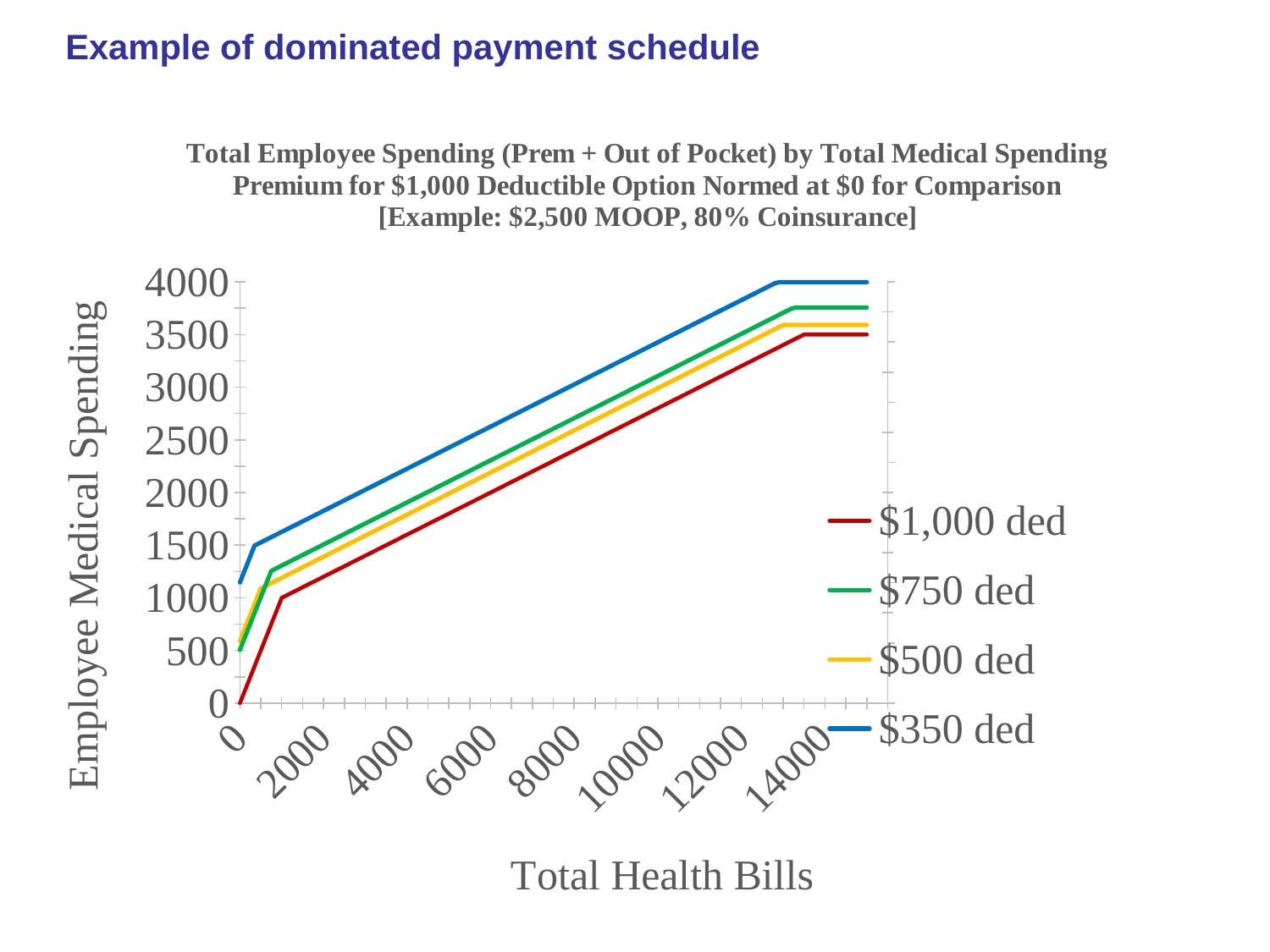
What is the title of the x axis? Total Health Bills What kind of chart is shown on the slide? line chart What is the value of the $1,000 ded series at total health bills of 0? 0 Is the value for the $1,000 ded series at total health bills of 4000 greater or less than 2000? less Which series has the highest employee medical spending across the range of total health bills? $350 ded Do the lines rise or fall as total health bills increase from 0 to 12000? rise What are the four series listed in the legend? $1,000 ded, $750 ded, $500 ded, $350 ded Is the value for the $350 ded series at total health bills of 8000 greater or less than 2500? greater Which series has the lowest employee medical spending across the range of total health bills? $1,000 ded At total health bills of 6000, which is larger: the $750 ded series or the $500 ded series? $750 ded How many series does the legend list? 4